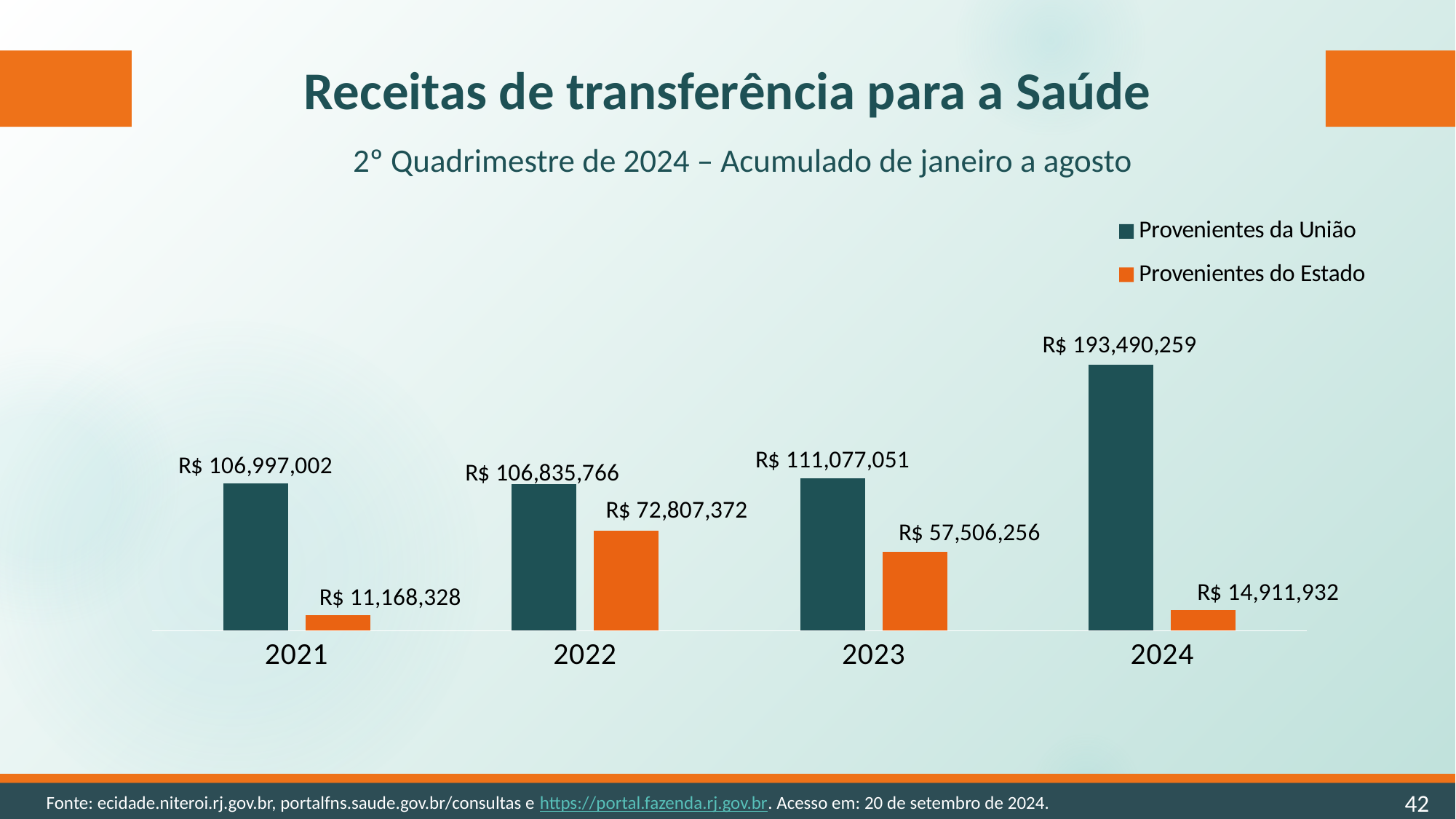
How many series does the legend list? 2 In which year is the value for Provenientes da União highest? 2024 What is the value for Provenientes do Estado in 2021? R$ 11,168,328 What is the value for Provenientes da União in 2024? R$ 193,490,259 In which year is the value for Provenientes do Estado highest? 2022 In which year is the value for Provenientes do Estado lowest? 2021 What is the value for Provenientes do Estado in 2022? R$ 72,807,372 What kind of chart is shown on the slide? Bar chart What is the difference between Provenientes da União and Provenientes do Estado in 2024? R$ 178,578,327 What is the difference between the Provenientes do Estado values for 2022 and 2023? R$ 15,301,116 Which is larger in 2023: Provenientes da União or Provenientes do Estado? Provenientes da União What is the value for Provenientes da União in 2023? R$ 111,077,051